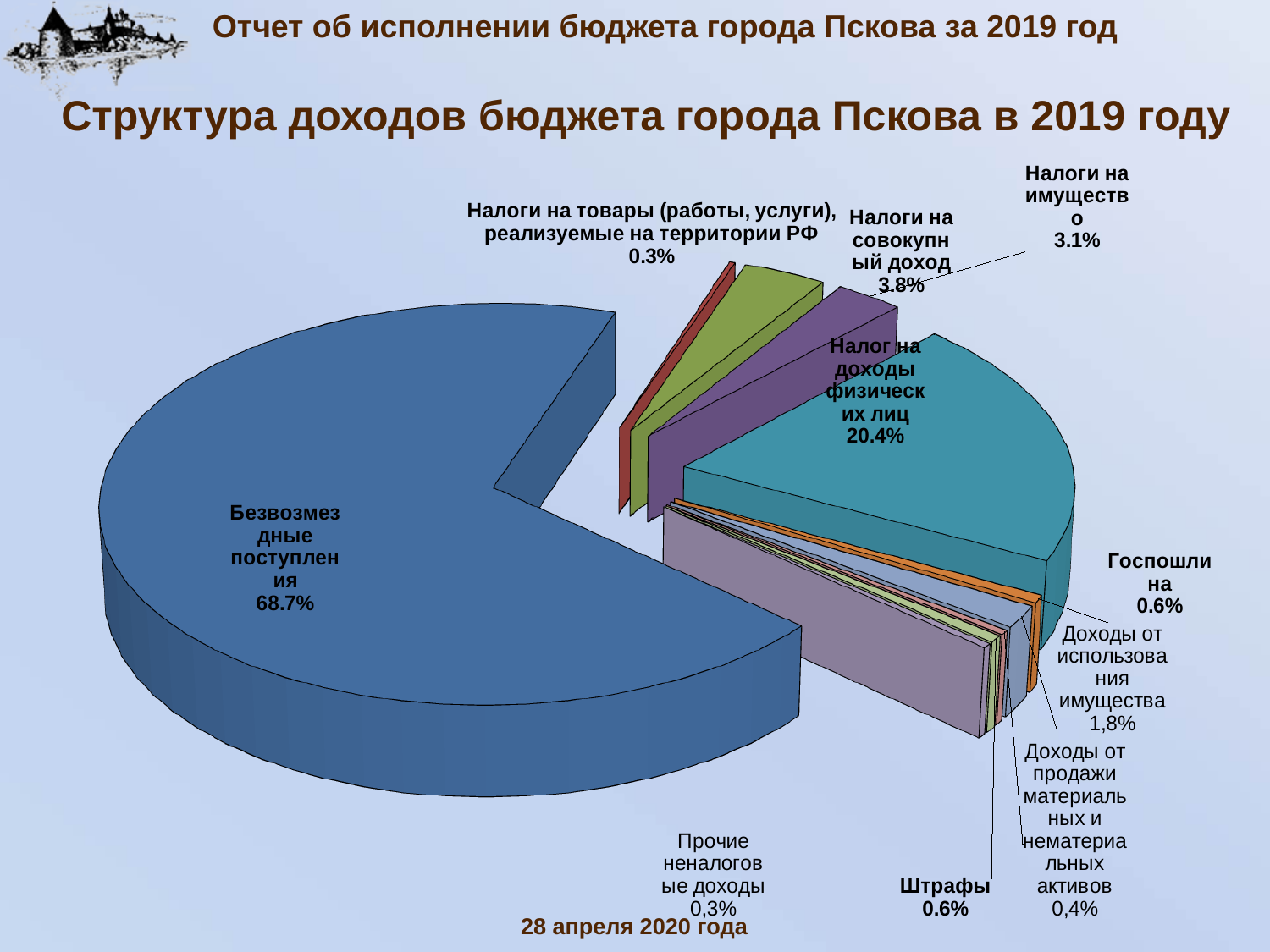
How many categories (slices) does the pie chart have? 10 What share of the pie is Безвозмездные поступления? 68.7% Which is larger, Налоги на совокупный доход or Налоги на имущество? Налоги на совокупный доход What is the value shown for Налог на доходы физических лиц? 20.4% What kind of chart is shown on the slide? pie chart Which category has the largest slice of the pie? Безвозмездные поступления What is the value shown for Доходы от продажи материальных и нематериальных активов? 0,4% What is the value shown for Налоги на имущество? 3.1% What is the difference between Безвозмездные поступления and Налог на доходы физических лиц? 48.3% What is the value shown for Доходы от использования имущества? 1,8% What is the value shown for Налоги на совокупный доход? 3.8% What is the title of the chart? Структура доходов бюджета города Пскова в 2019 году